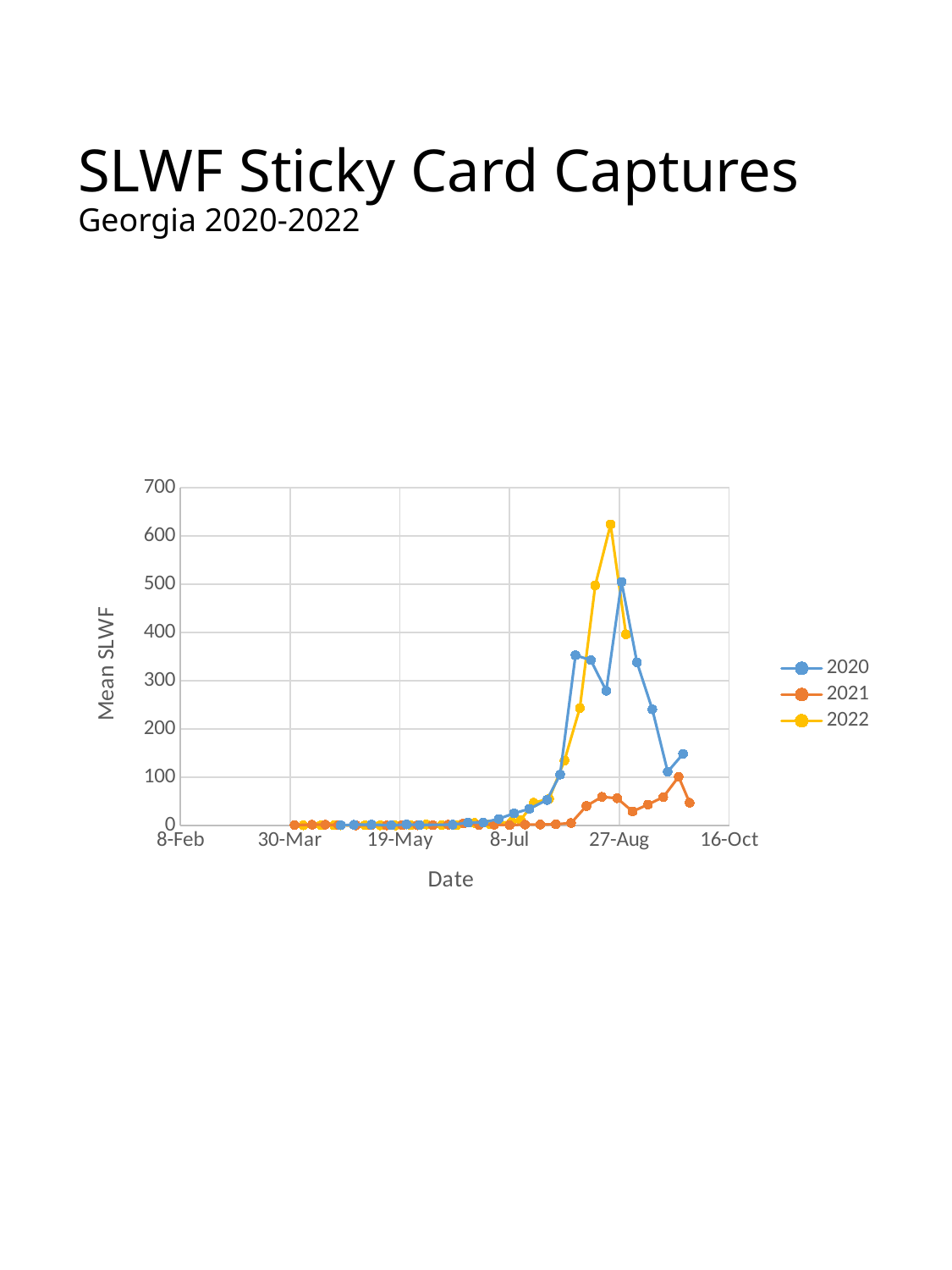
Is the peak value of the 2020 series greater or less than 400? greater Is the peak value of the 2021 series greater or less than 200? less What colour is the line for the 2021 series? orange Do the values for the 2020 series rise or fall between 27-Aug and mid-September? fall What kind of chart is shown on the slide? line chart What is the label on the vertical axis? Mean SLWF Which series has the larger peak, 2020 or 2021? 2020 Is the peak value of the 2022 series greater or less than 500? greater Which series has the lowest peak value? 2021 Do the values for the 2022 series rise or fall between 8-Jul and its peak in late August? rise Which series reaches the highest peak value? 2022 How many series does the legend list? 3